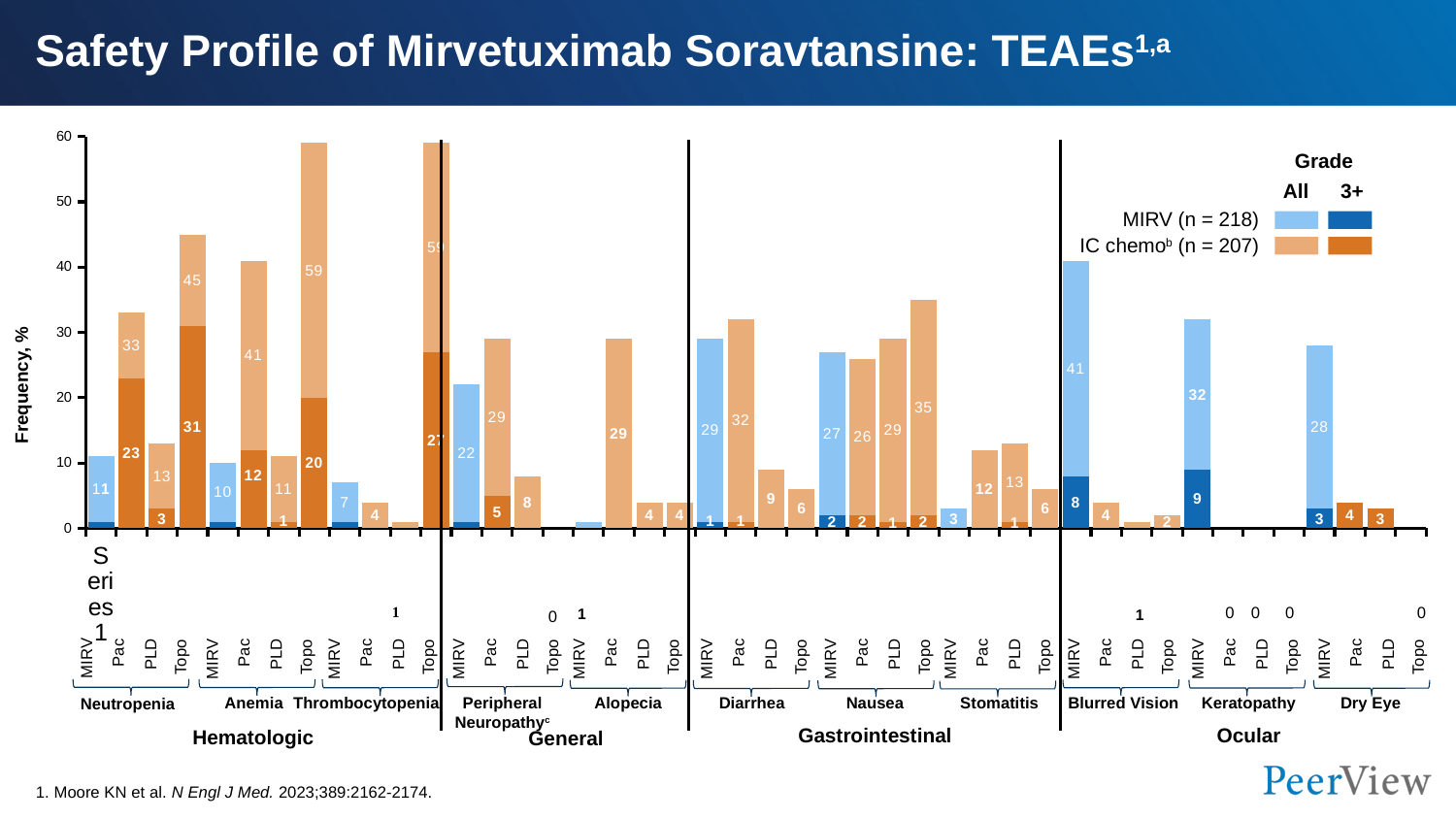
How many adverse event categories are shown on the x axis? 11 What is the grade 3+ frequency of keratopathy for MIRV? 9 What is the all-grade frequency of blurred vision for MIRV? 41 What is the grade 3+ frequency of neutropenia for Topo? 31 Among the ocular events, which has the lowest all-grade frequency for MIRV? Dry Eye Which is larger, the all-grade diarrhea frequency for MIRV or for Pac? Pac What is the difference between the all-grade nausea frequency for Topo and for MIRV? 8 What kind of chart is shown on the slide? Bar chart Is the all-grade thrombocytopenia frequency for Topo greater or less than 50? greater Which treatment has the highest all-grade frequency of anemia? Topo According to the legend, what is the n for the IC chemo group? 207 What is the all-grade frequency of keratopathy for MIRV? 32